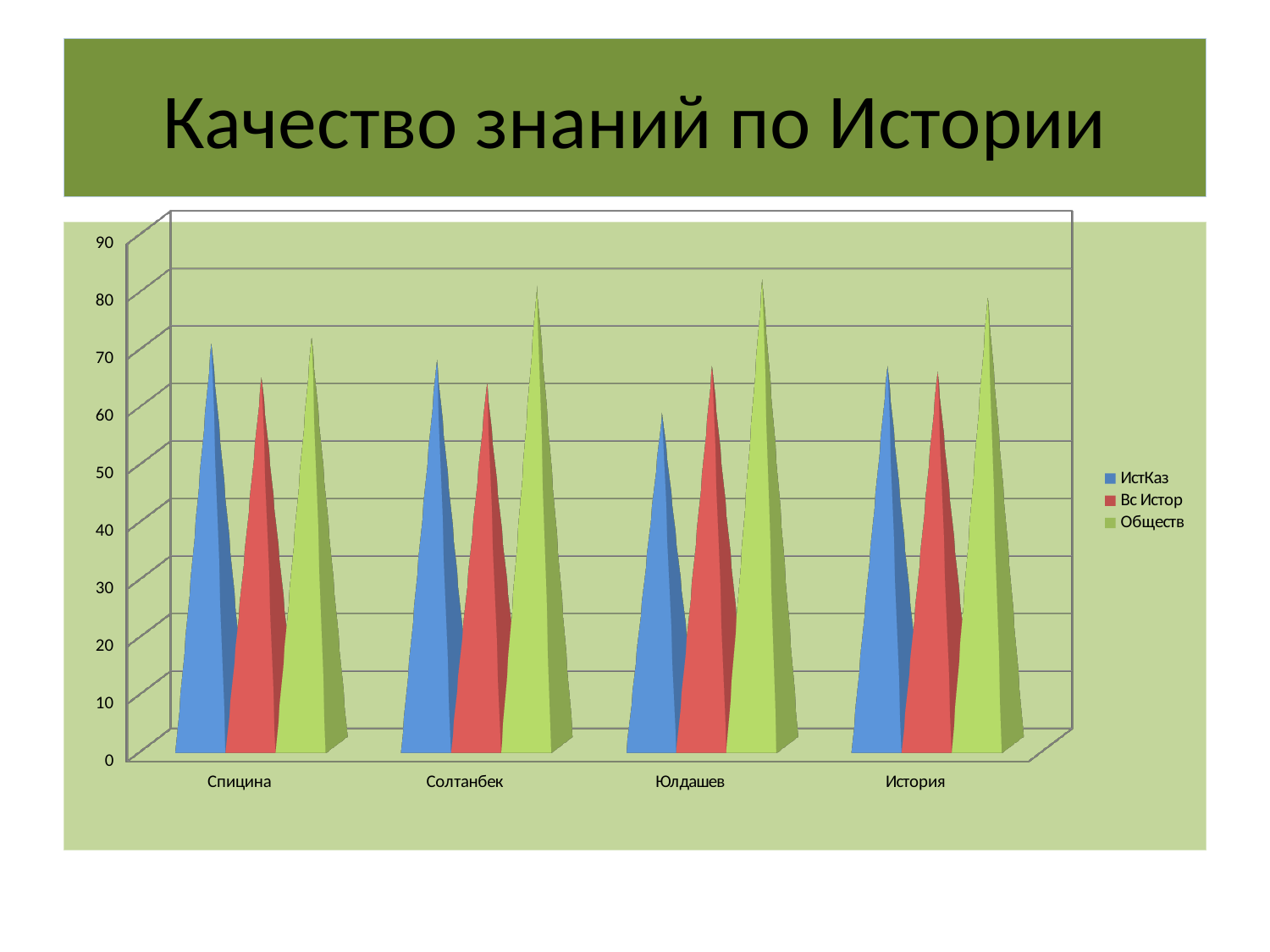
Which series is shown in green in the legend? Обществ What is the title of the slide containing the chart? Качество знаний по Истории How many categories are shown along the x axis? 4 Which series has the lowest value for Юлдашев? ИстКаз How many series does the legend list? 3 Which series has the highest value for Солтанбек? Обществ Is the value of Вс Истор for Спицина greater or less than 50? greater Is the value of Обществ for Юлдашев greater or less than 70? greater Is the value of Обществ for Солтанбек greater or less than 70? greater What kind of chart is shown on the slide? bar chart For История, which is larger: Обществ or Вс Истор? Обществ